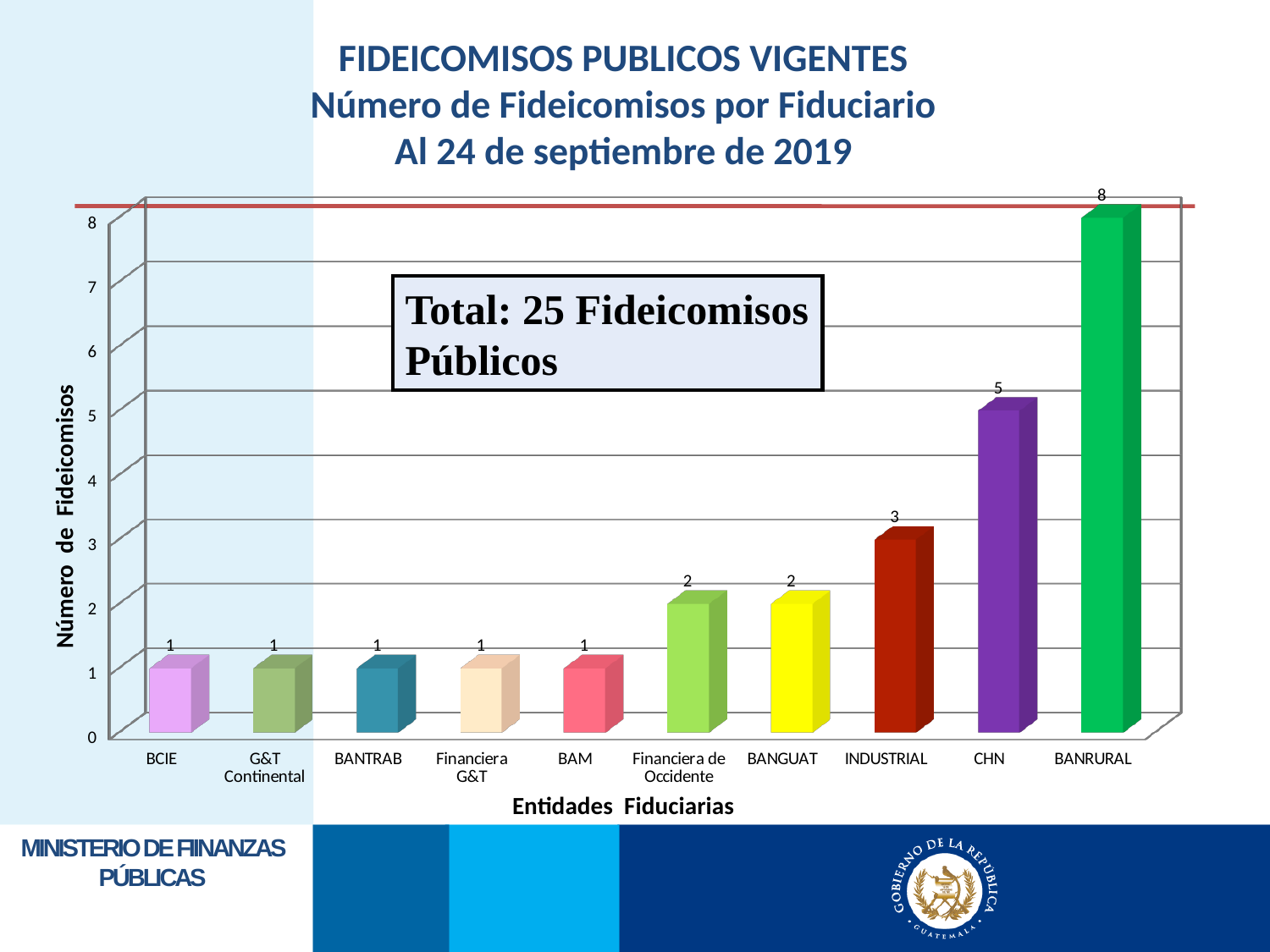
What kind of chart is shown? Bar chart Do the values rise or fall from left to right along the x axis? Rise What is the value for INDUSTRIAL? 3 What total number of fideicomisos públicos is stated in the text box on the chart? 25 Which entity has the highest number of fideicomisos? BANRURAL What is the value for BANGUAT? 2 How many entities have a value of 1? 5 How many entities (categories) are shown on the x axis? 10 How many fideicomisos does BANRURAL have? 8 Which is larger, the value for INDUSTRIAL or the value for Financiera de Occidente? INDUSTRIAL What is the value for CHN? 5 What is the difference between the values for BANRURAL and CHN? 3